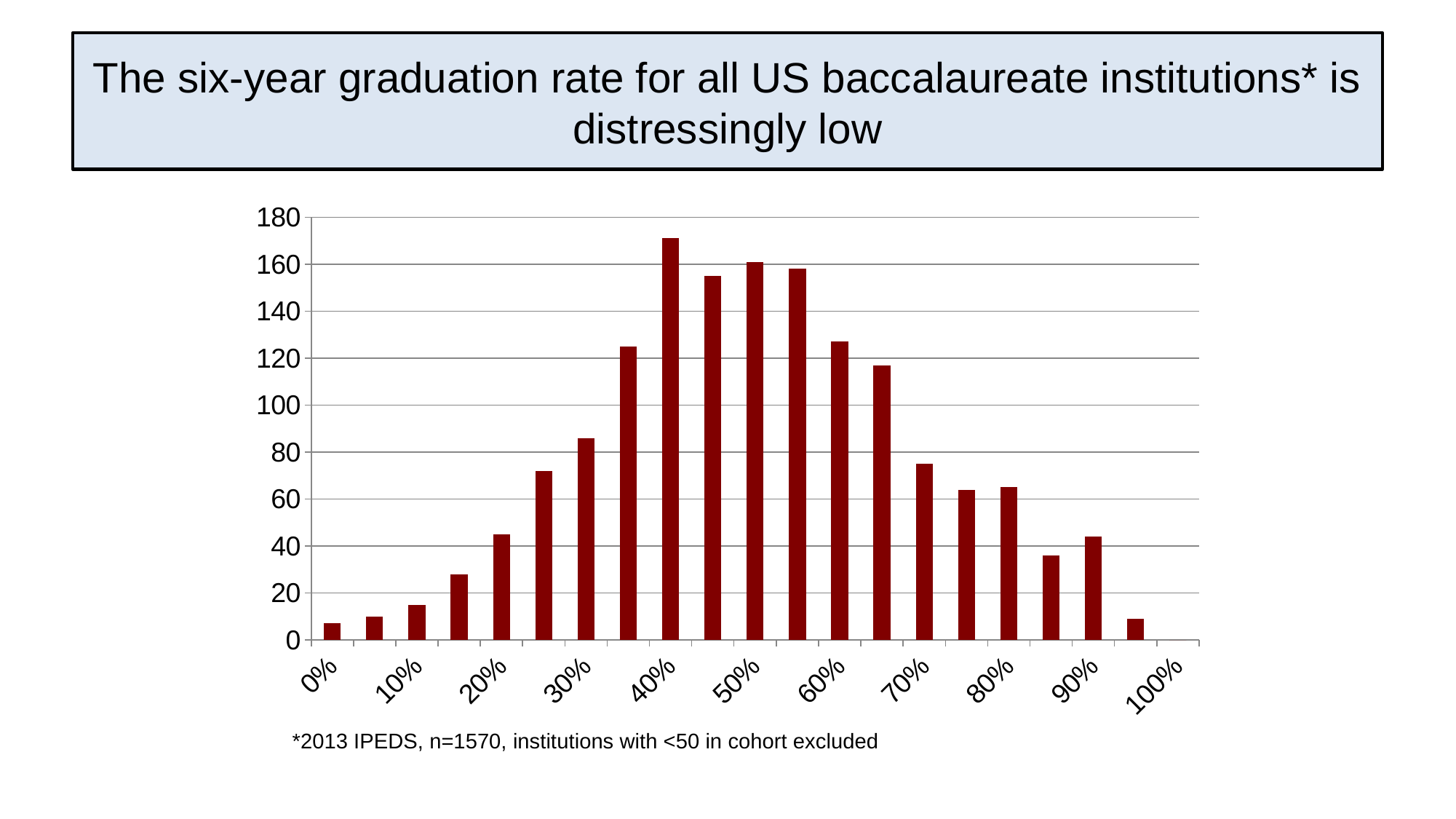
What colour are the bars in the chart? dark red Which x-axis category has the tallest bar? 40% Which bar is taller, the one at 40% or the one at 90%? 40% Do the bar values rise or fall from 50% to 90% along the x axis? fall Do the bar values rise or fall from 0% to 40% along the x axis? rise Is the value for the 0% bar greater or less than 20? less What kind of chart is shown on the slide? bar chart Is the value for the 30% bar greater or less than 60? greater Is the value for the 90% bar greater or less than 60? less Which bar is taller, the one at 10% or the one at 50%? 50%